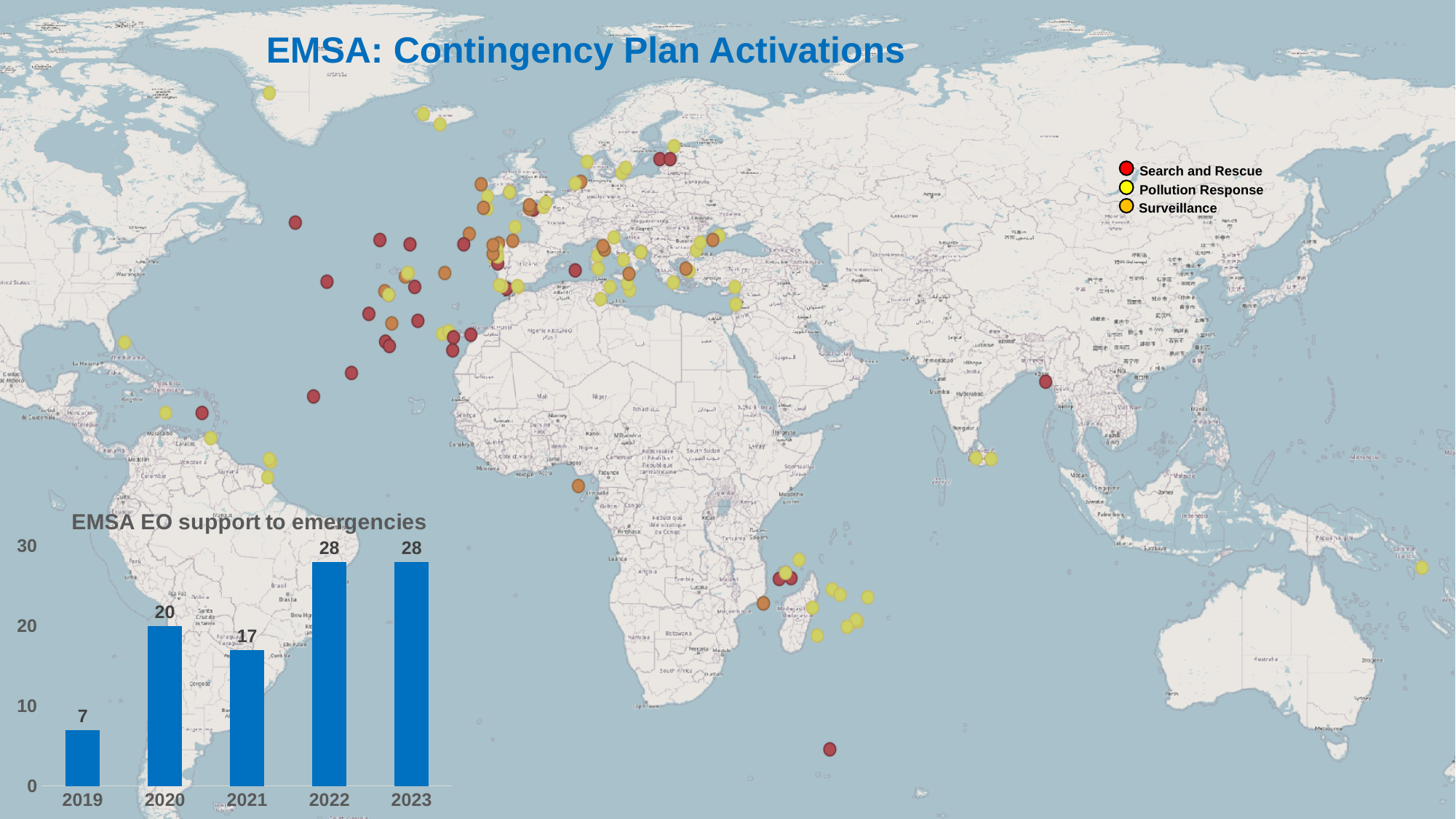
In the 'EMSA EO support to emergencies' chart, which is larger, the value for 2020 or the value for 2021? 2020 In the 'EMSA EO support to emergencies' chart, what is the value for 2023? 28 In the 'EMSA EO support to emergencies' chart, what is the value for 2020? 20 How many categories does the legend of the map list? 3 In the 'EMSA EO support to emergencies' chart, what is the difference between the values for 2020 and 2021? 3 In the 'EMSA EO support to emergencies' chart, what is the value for 2021? 17 In the 'EMSA EO support to emergencies' chart, what is the value for 2019? 7 In the 'EMSA EO support to emergencies' chart, what is the difference between the values for 2022 and 2019? 21 In the 'EMSA EO support to emergencies' chart, is the value for 2021 greater or less than 20? less In the 'EMSA EO support to emergencies' chart, how many years are shown on the x axis? 5 In the 'EMSA EO support to emergencies' chart, which year has the lowest value? 2019 What kind of chart is 'EMSA EO support to emergencies'? bar chart